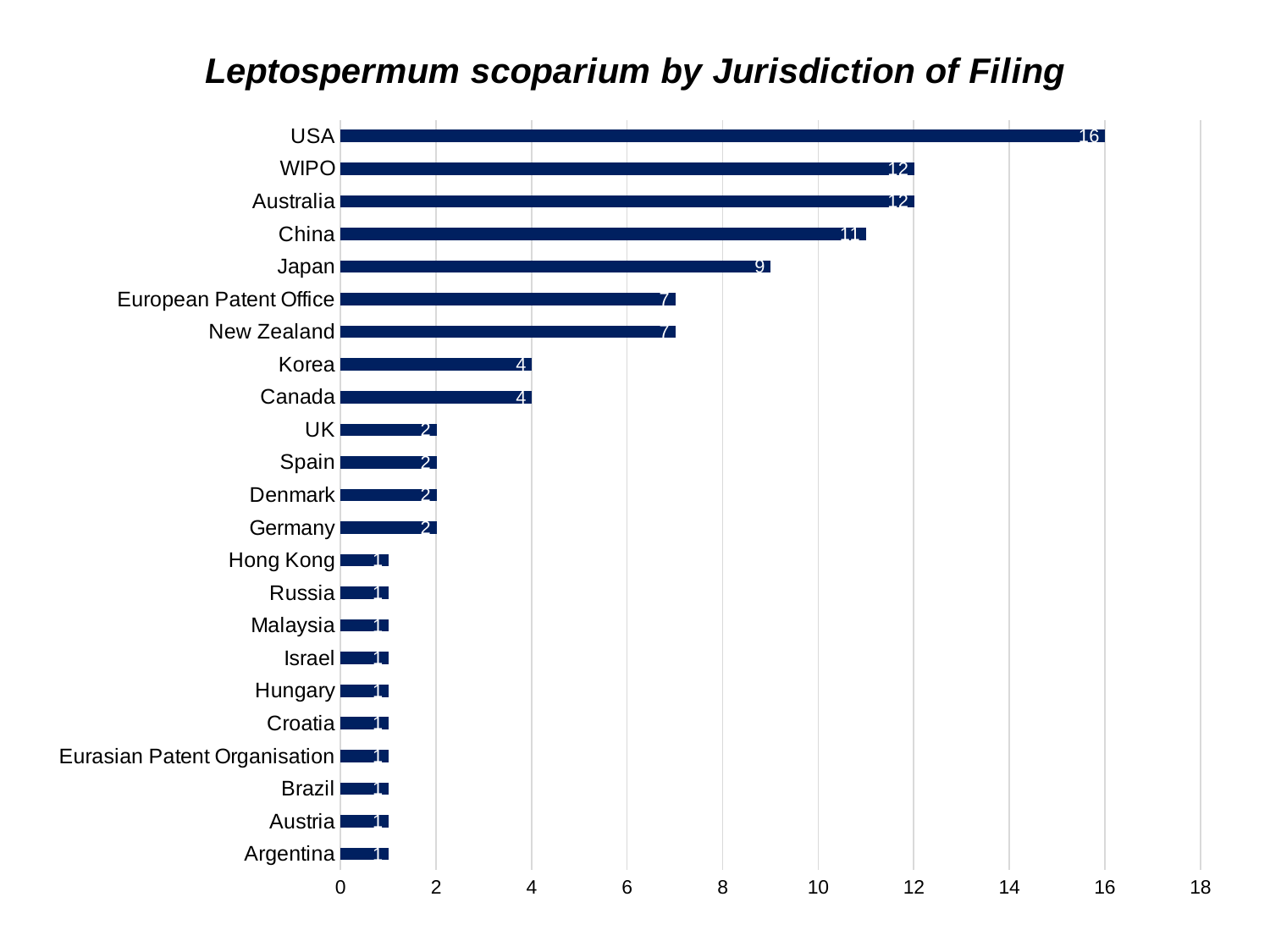
What is the value for USA? 16 How many jurisdictions are shown on the chart? 23 Is the value for New Zealand greater or less than 6? greater Which is larger, the value for China or the value for Japan? China What is the title of the chart? Leptospermum scoparium by Jurisdiction of Filing What is the difference between the values for Japan and Korea? 5 What is the value for Japan? 9 What is the difference between the values for USA and WIPO? 4 What is the value for the European Patent Office? 7 What kind of chart is shown on the slide? Bar chart Which jurisdiction has the highest value? USA What is the value for China? 11